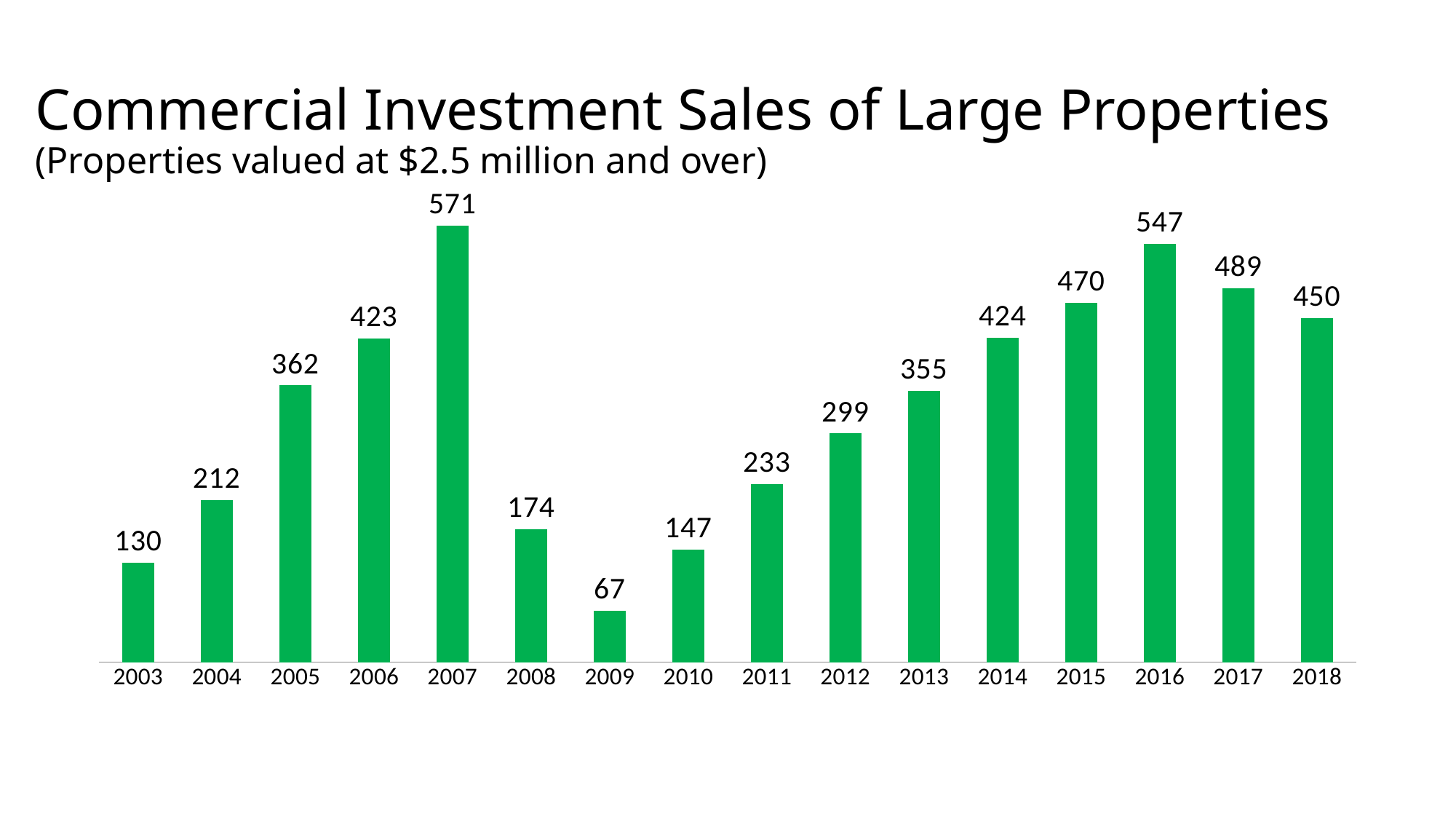
Do the values rise or fall from 2009 to 2016? Rise What is the value for 2007? 571 Which year has the lowest value? 2009 What is the value for 2014? 424 What is the value for 2009? 67 What is the difference between the values for 2007 and 2008? 397 What kind of chart is shown on the slide? Bar chart Which year has the highest value? 2007 What is the title of the chart? Commercial Investment Sales of Large Properties How many years are shown on the x axis? 16 What is the difference between the values for 2016 and 2018? 97 Which is larger, the value for 2006 or the value for 2014? 2014